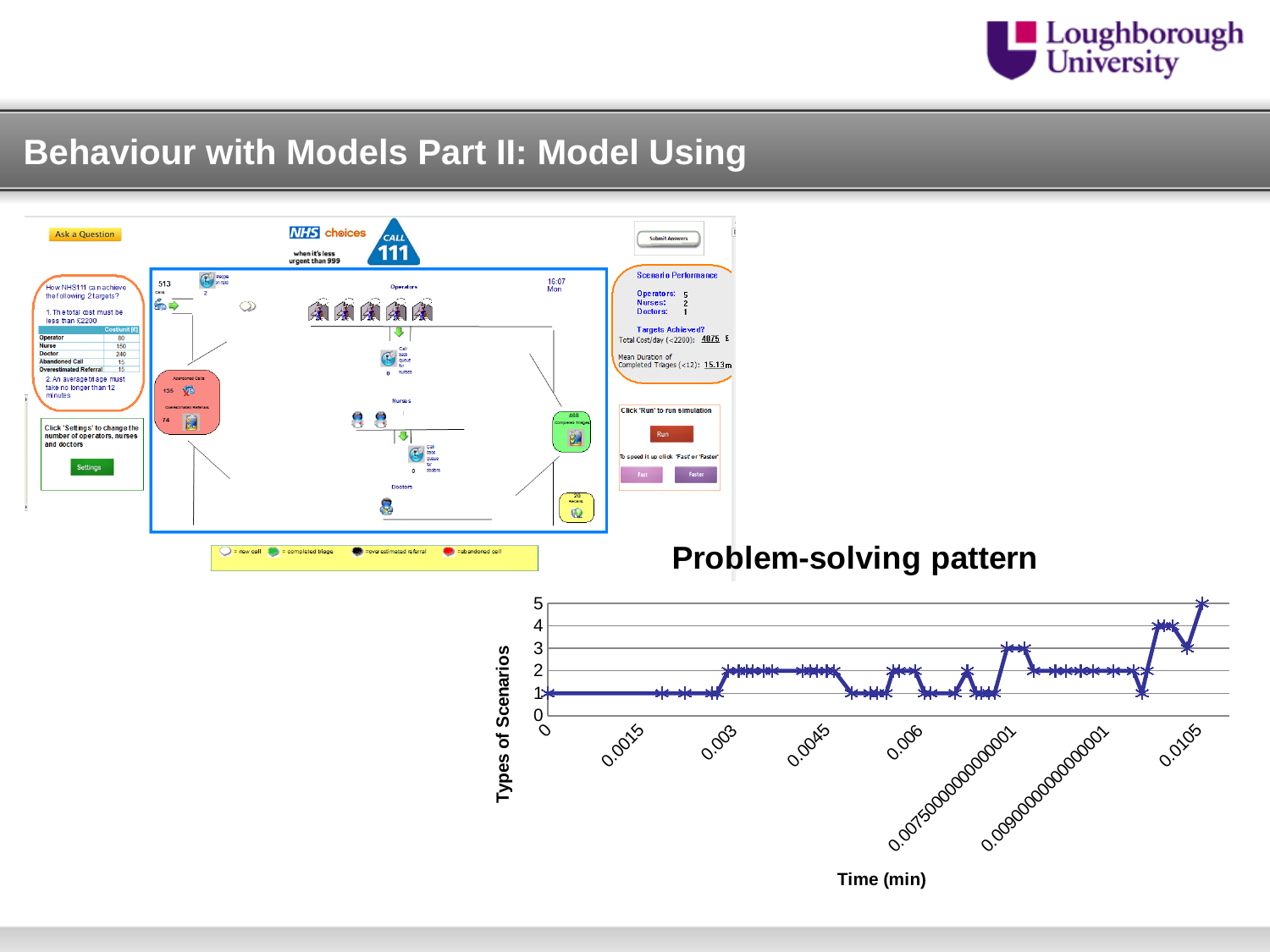
In the "Problem-solving pattern" chart, is the final value at the right end of the line greater or less than 4? greater In the "Problem-solving pattern" chart, what is the difference between the highest and lowest values reached by the line? 4 What is the title of the chart on the slide? Problem-solving pattern In the "Problem-solving pattern" chart, which is larger: the value at time 0 or the value at time 0.0105? the value at time 0.0105 In the "Problem-solving pattern" chart, what is the highest value the line reaches on the y axis? 5 What kind of chart is the "Problem-solving pattern" chart? line chart What is the label of the x axis of the "Problem-solving pattern" chart? Time (min) In the "Problem-solving pattern" chart, what is the value of the line at time 0? 1 In the "Problem-solving pattern" chart, is the value at time 0.0015 greater or less than 2? less In the "Problem-solving pattern" chart, what is the lowest value the line reaches on the y axis? 1 In the "Problem-solving pattern" chart, does the line overall rise or fall from left to right? rise